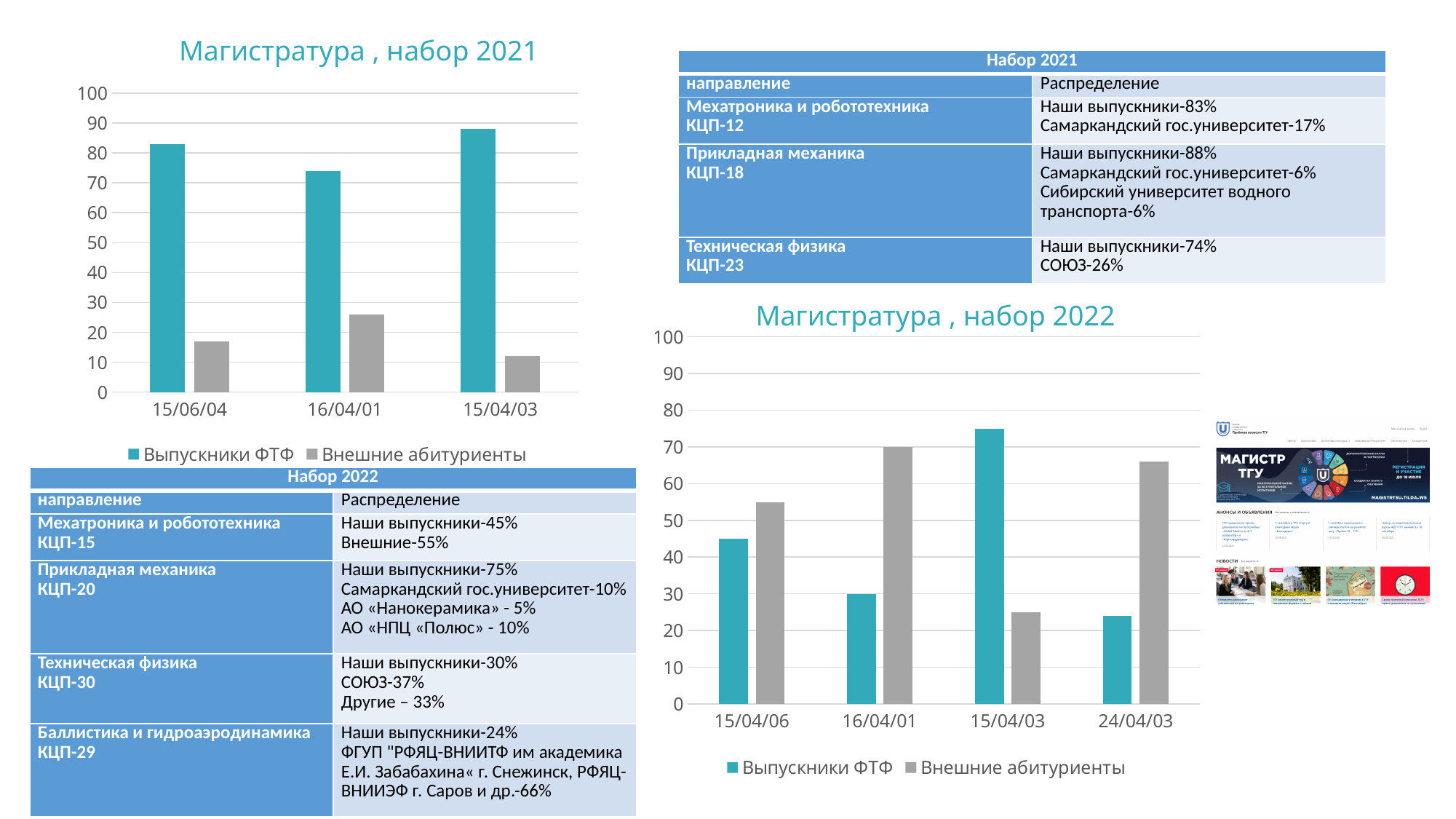
What colour are the Внешние абитуриенты bars in the "Магистратура , набор 2022" chart? gray What kind of chart is "Магистратура , набор 2021"? bar chart In the "Магистратура , набор 2021" chart, which category has the highest value for Выпускники ФТФ? 15/04/03 In the "Магистратура , набор 2022" chart, is the value for Выпускники ФТФ at 15/04/03 greater or less than 70? greater In the "Магистратура , набор 2021" chart, is the value for Внешние абитуриенты at 16/04/01 greater or less than 20? greater In the "Магистратура , набор 2022" chart, which is larger at 15/04/06: Выпускники ФТФ or Внешние абитуриенты? Внешние абитуриенты In the "Магистратура , набор 2021" chart, which category has the lowest value for Внешние абитуриенты? 15/04/03 How many categories are shown on the x axis of the "Магистратура , набор 2022" chart? 4 How many series does the legend of the "Магистратура , набор 2021" chart list? 2 In the "Магистратура , набор 2022" chart, which category has the highest value for Внешние абитуриенты? 16/04/01 In the "Магистратура , набор 2021" chart, which is larger at 16/04/01: Выпускники ФТФ or Внешние абитуриенты? Выпускники ФТФ In the "Магистратура , набор 2022" chart, which category has the lowest value for Выпускники ФТФ? 24/04/03